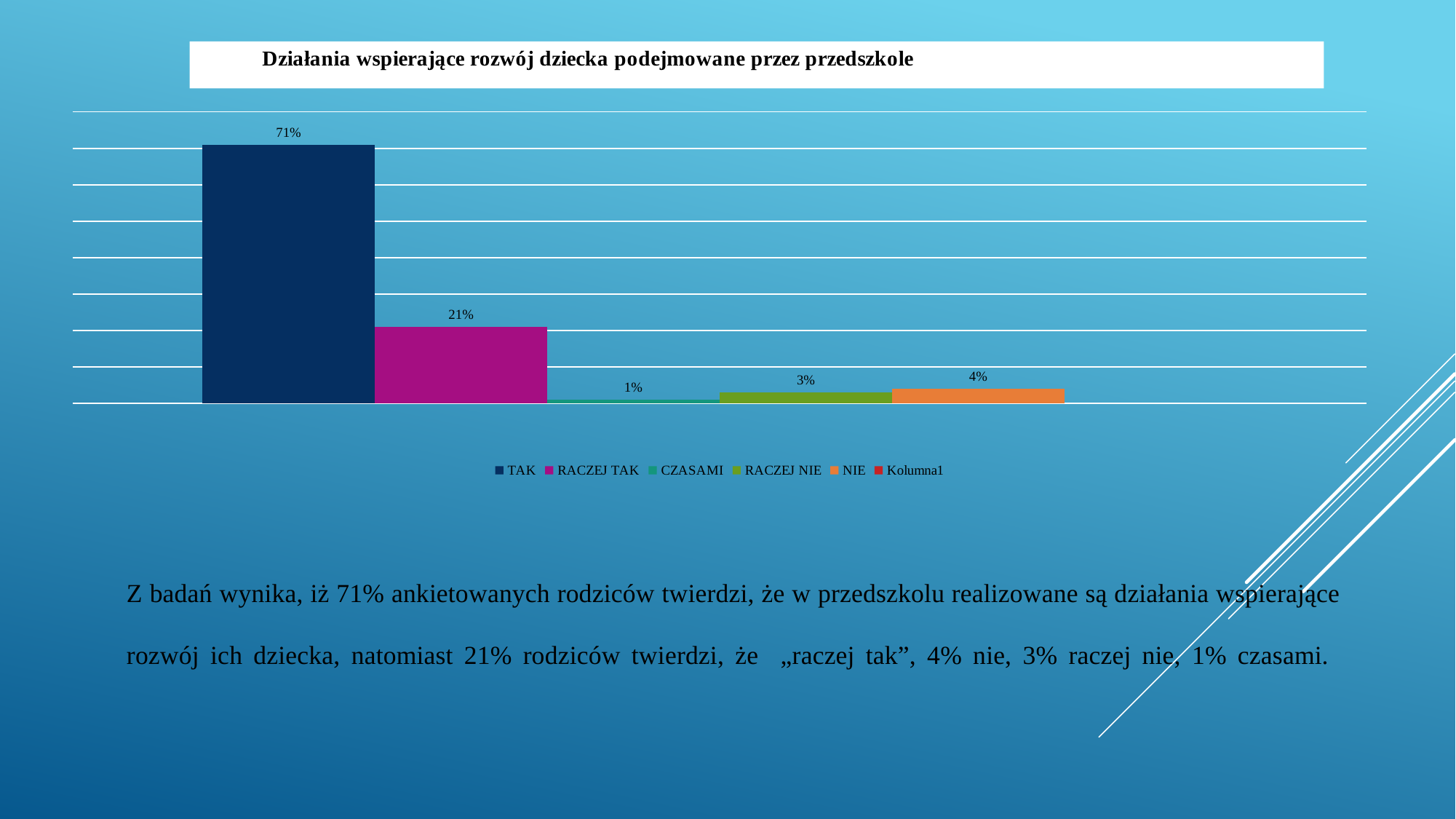
Which is larger, the value for NIE or the value for RACZEJ NIE? NIE Which series has the lowest value among the plotted bars? CZASAMI What is the title of the chart? Działania wspierające rozwój dziecka podejmowane przez przedszkole What is the difference between the values for TAK and RACZEJ TAK? 50% What kind of chart is shown on the slide? Bar chart Which series has the highest value? TAK What is the value for CZASAMI? 1% What is the value for NIE? 4% What is the value for TAK? 71% What is the value for RACZEJ TAK? 21% How many entries does the legend list? 6 How many bars are plotted on the chart? 5